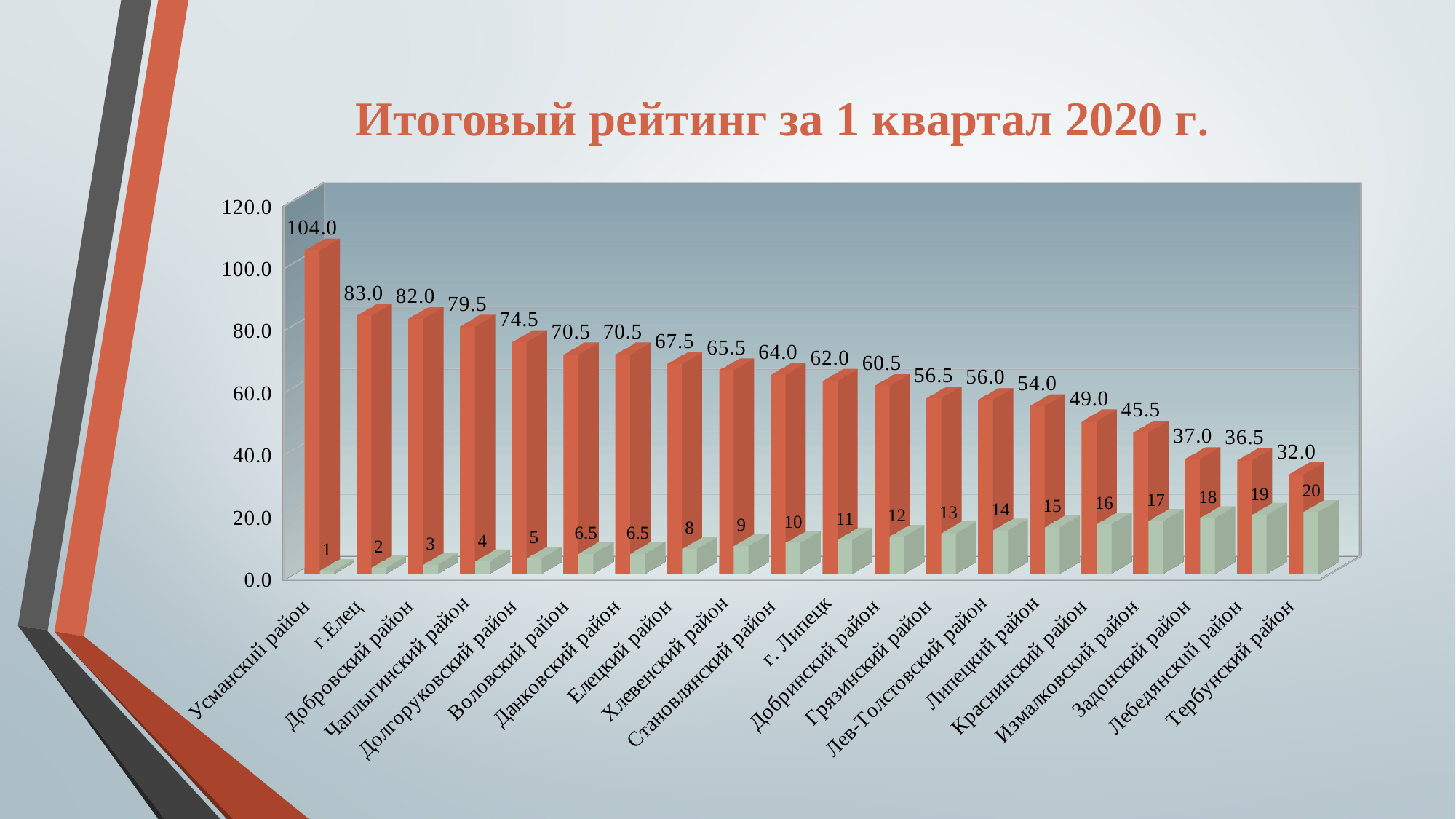
Do the rating values rise or fall from left to right along the x axis? fall Which has a higher rating value, Добринский район or Липецкий район? Добринский район What rank number is shown for both Воловский район and Данковский район? 6.5 Which category has the lowest rating value? Тербунский район What type of chart is shown on the slide? bar chart What is the difference between the rating values of г.Елец and Тербунский район? 51.0 How many categories are shown on the x axis? 20 What is the rating value shown for г. Липецк? 62.0 What is the rating value shown for Усманский район? 104.0 Which category has the highest rating value? Усманский район What rank number is shown for Хлевенский район? 9 What is the title of the chart? Итоговый рейтинг за 1 квартал 2020 г.